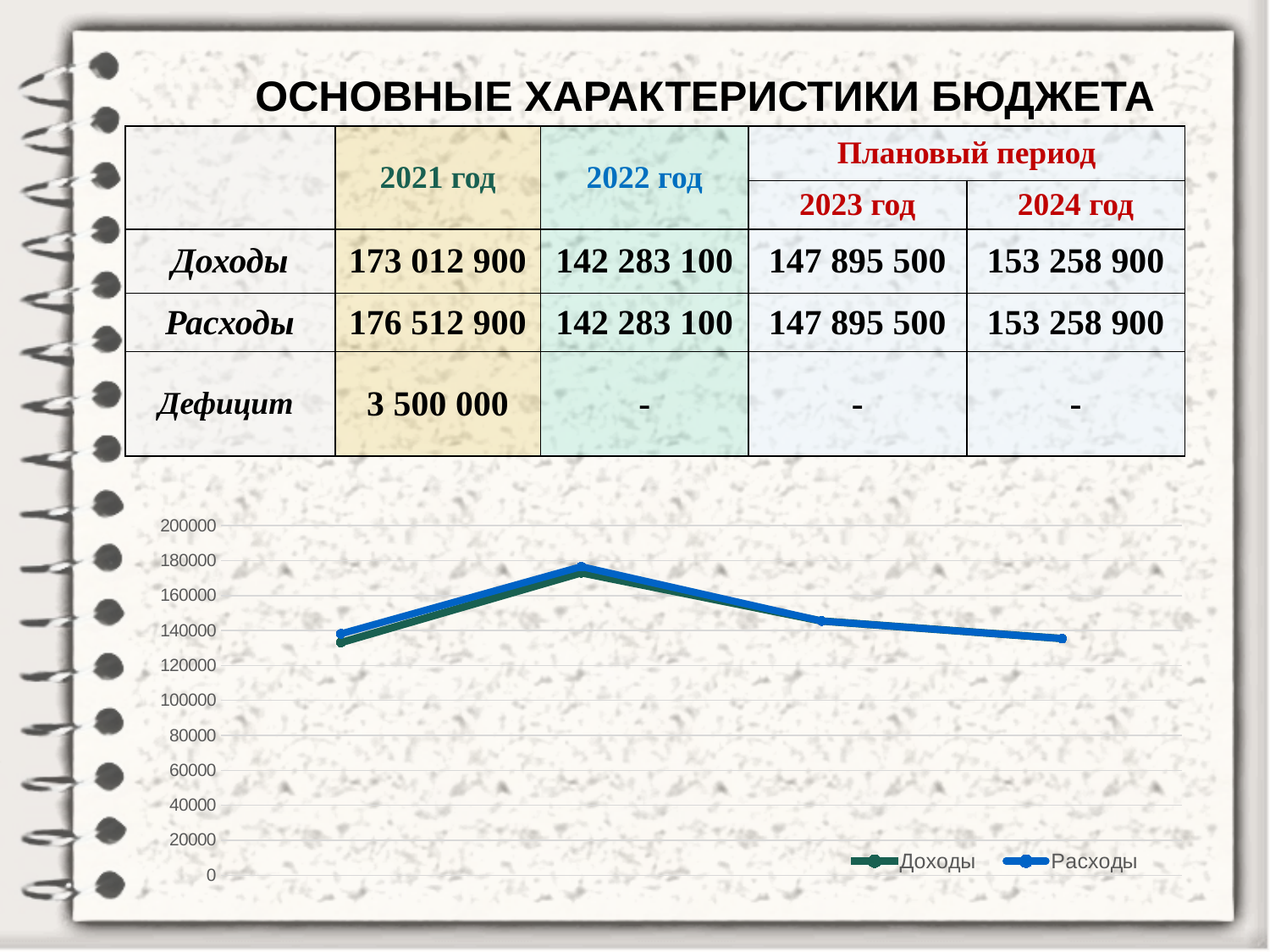
Do the lines rise or fall from the first point to the second point? rise Is the first point of the Доходы line greater or less than 120000? greater How many data points does each line in the chart have? 4 Do the lines rise or fall from the second point to the last point? fall What kind of chart is shown at the bottom of the slide? line chart Is the last point of the Расходы line greater or less than 160000? less What are the two series named in the chart legend? Доходы and Расходы What is the highest value shown on the chart's vertical axis? 200000 Which data point along the x axis is the highest for the Расходы line? the second point Is the peak value of the Расходы line greater or less than 160000? greater How many series does the chart legend list? 2